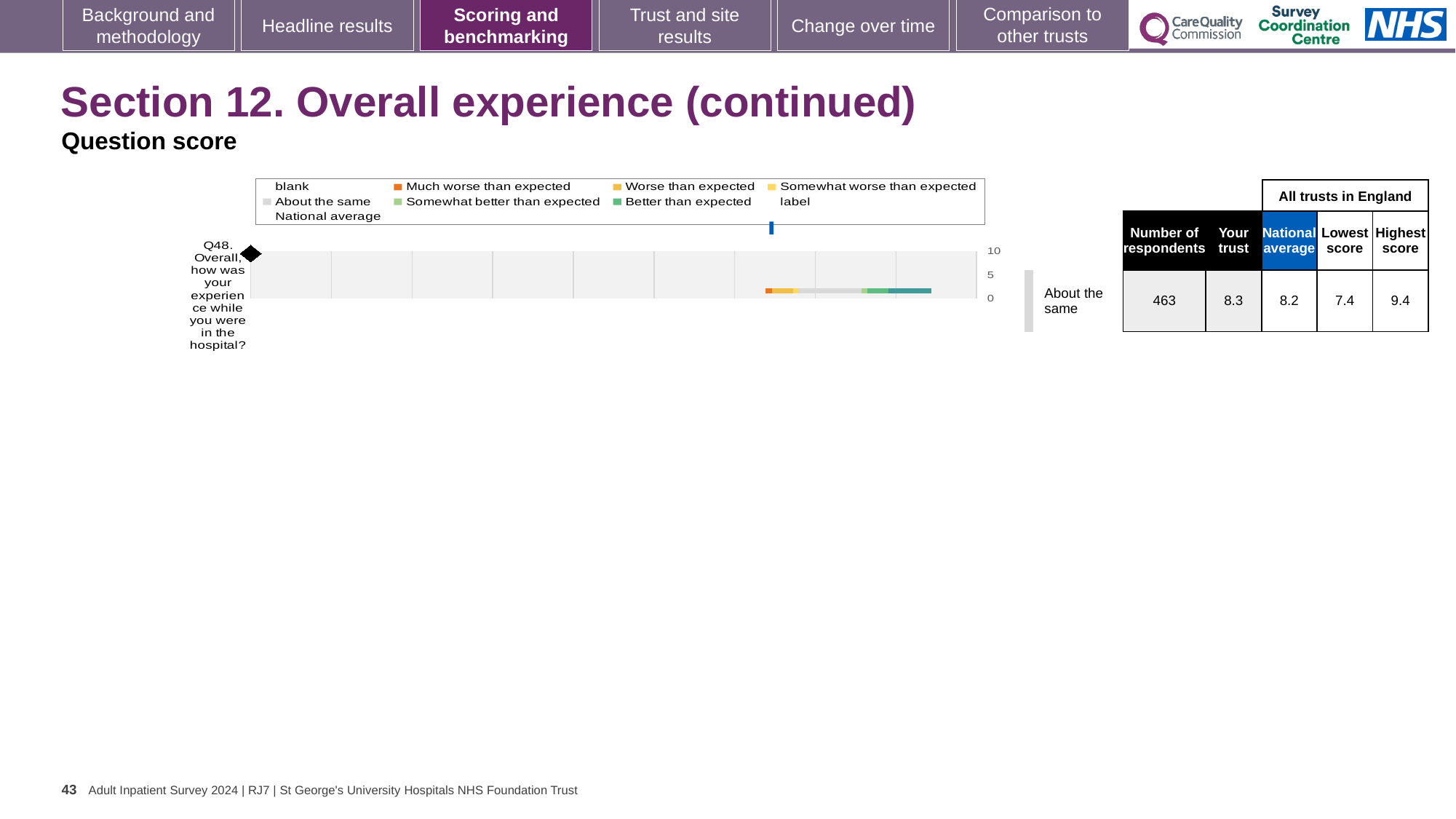
What is the difference between the highest and lowest scores for Q48? 2.0 What is the highest score among all trusts in England for Q48? 9.4 How many survey questions are plotted on the chart? 1 How many respondents answered Q48? 463 Which is larger for Q48, the 'Your trust' score or the national average? Your trust What is the national average score for Q48? 8.2 Which benchmark category is the trust's Q48 score placed in? About the same Which legend entry is shown in orange? Much worse than expected Which question is plotted on the chart? Q48. Overall, how was your experience while you were in the hospital? What kind of chart is used to show the Q48 question score? Bar chart What is the 'Your trust' score for Q48? 8.3 What is the lowest score among all trusts in England for Q48? 7.4